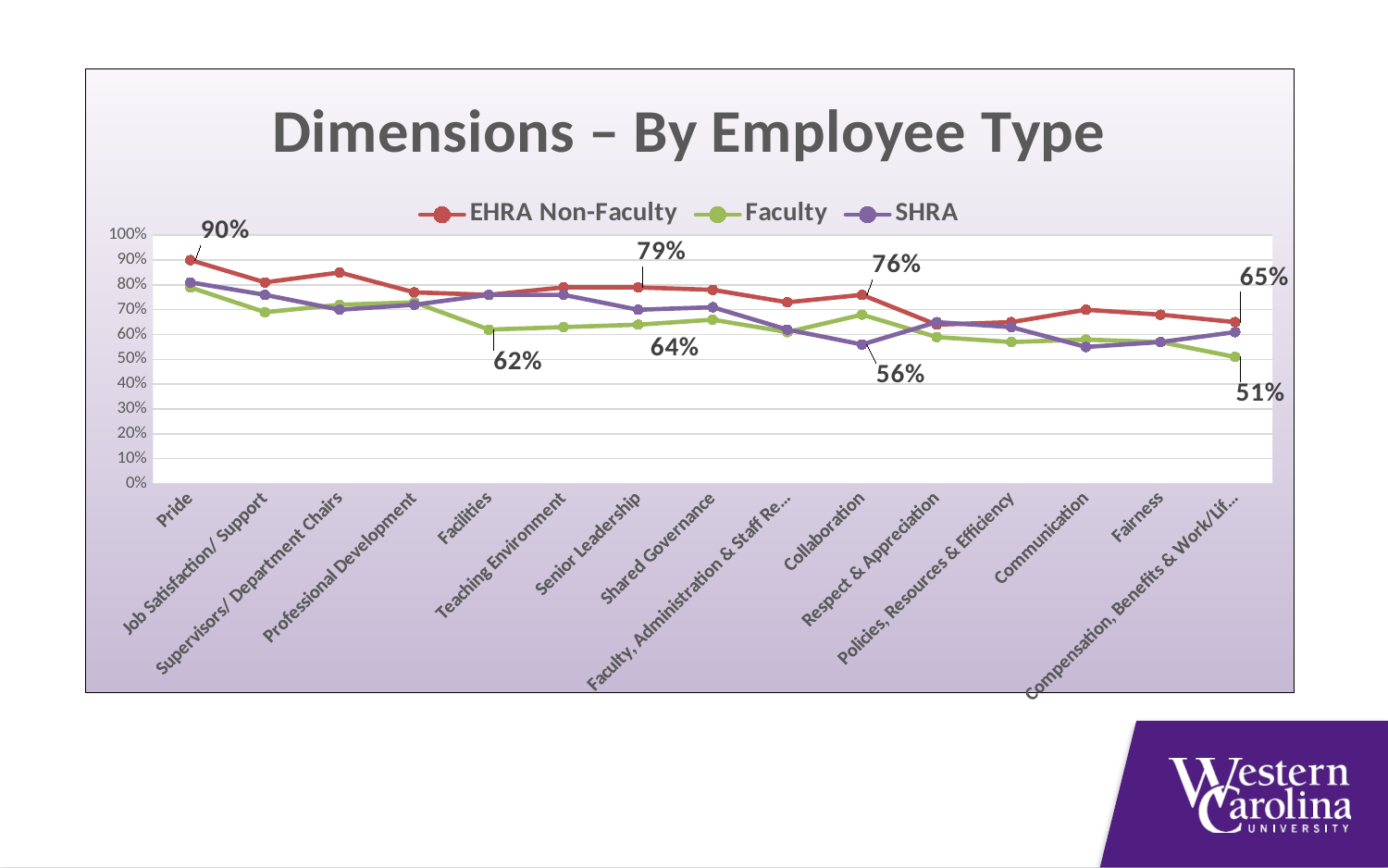
Does the EHRA Non-Faculty line generally rise or fall from Pride to Compensation, Benefits & Work/Life? fall How many series does the legend list? 3 What is the EHRA Non-Faculty value for Pride? 90% How many dimension categories are shown on the x axis? 15 What is the SHRA value for Collaboration? 56% Which employee type has the highest value for Pride? EHRA Non-Faculty For Senior Leadership, which is larger: the EHRA Non-Faculty value or the Faculty value? EHRA Non-Faculty Is the SHRA value for Pride greater or less than 70%? greater What kind of chart is shown on the slide? line chart What is the difference between the EHRA Non-Faculty value for Pride (90%) and its value for the last category, Compensation, Benefits & Work/Life (65%)? 25 percentage points What is the EHRA Non-Faculty value for Senior Leadership? 79%